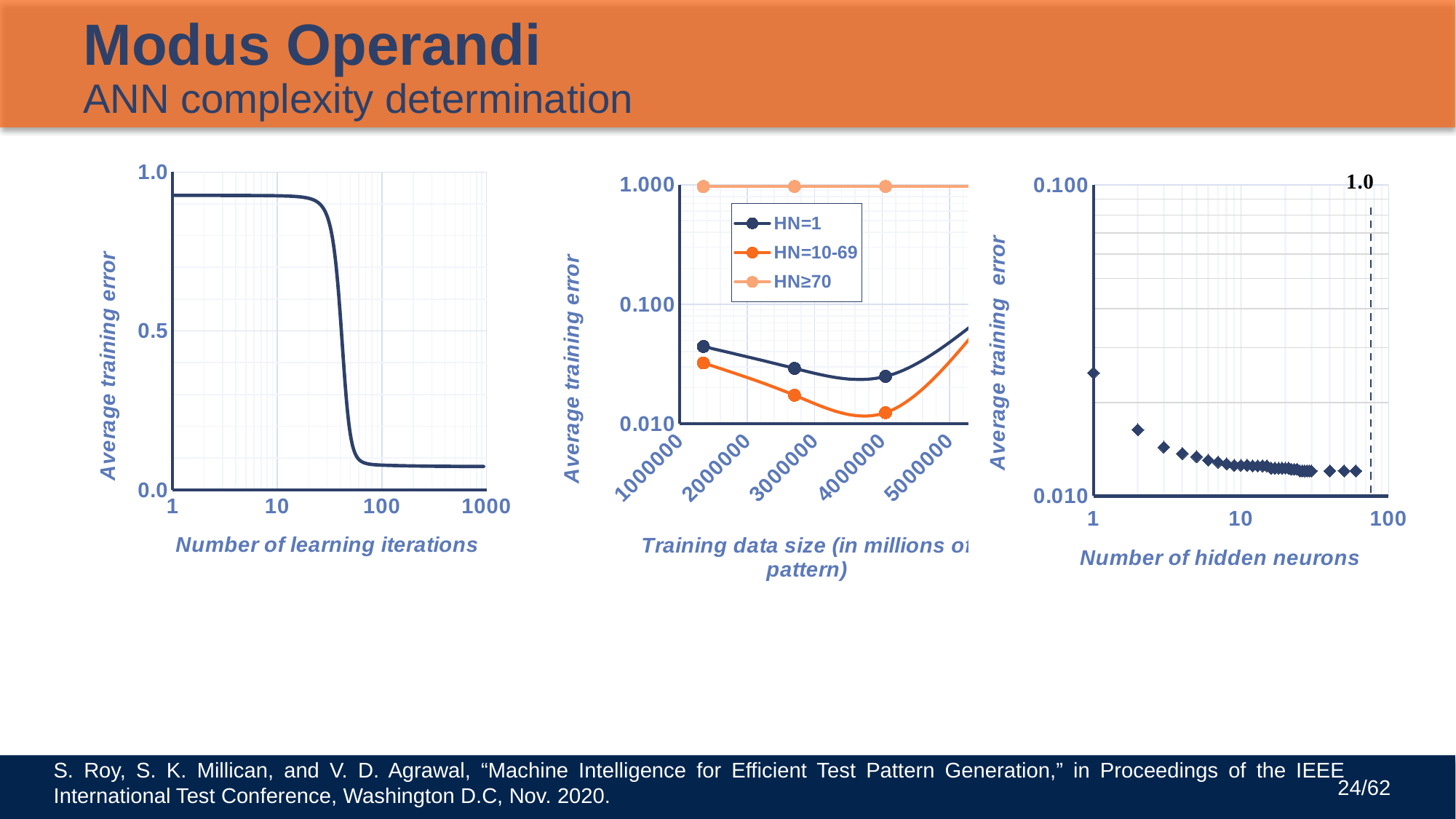
In the left chart (Number of learning iterations), does the average training error rise or fall as the number of learning iterations increases? fall In the middle chart (Training data size), which series has the highest average training error? HN≥70 In the left chart (Number of learning iterations), is the average training error at 1000 iterations greater or less than 0.5? less In the middle chart (Training data size), at a training data size of 2000000, which series has the larger average training error, HN=1 or HN=10-69? HN=1 What kind of chart is the left chart, 'Number of learning iterations'? line chart In the middle chart (Training data size), which series has the lowest average training error? HN=10-69 In the right chart (Number of hidden neurons), is the average training error at 1 hidden neuron greater or less than 0.100? less How many series does the legend of the middle chart (Training data size) list? 3 In the right chart (Number of hidden neurons), does the average training error rise or fall as the number of hidden neurons increases? fall In the middle chart (Training data size), is the average training error for HN=1 at 2000000 greater or less than 0.100? less